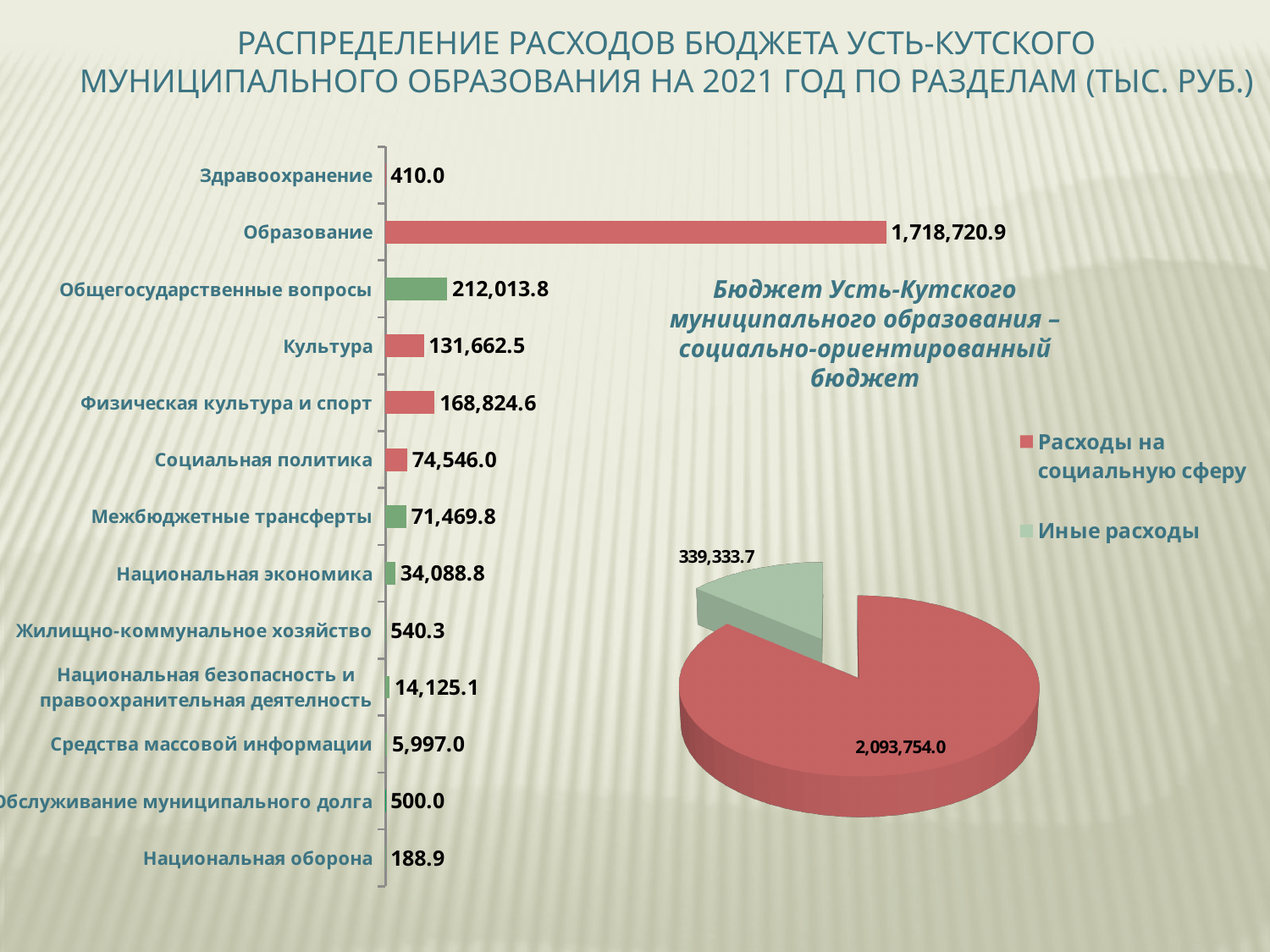
In the bar chart on the left, which is larger: Социальная политика or Межбюджетные трансферты? Социальная политика In the bar chart on the left, which category has the highest value? Образование In the bar chart on the left, which category has the lowest value? Национальная оборона What kind of chart is on the left of the slide? Bar chart In the pie chart on the right, what is the difference between Расходы на социальную сферу and Иные расходы? 1,754,420.3 In the bar chart on the left, what is the difference between Физическая культура и спорт and Культура? 37,162.1 How many categories does the bar chart on the left show? 13 In the pie chart on the right, what is the value for Иные расходы? 339,333.7 How many entries does the legend of the pie chart on the right list? 2 In the bar chart on the left, what is the value for Физическая культура и спорт? 168,824.6 In the bar chart on the left, what is the value for Национальная оборона? 188.9 In the bar chart on the left, what is the value for Образование? 1,718,720.9